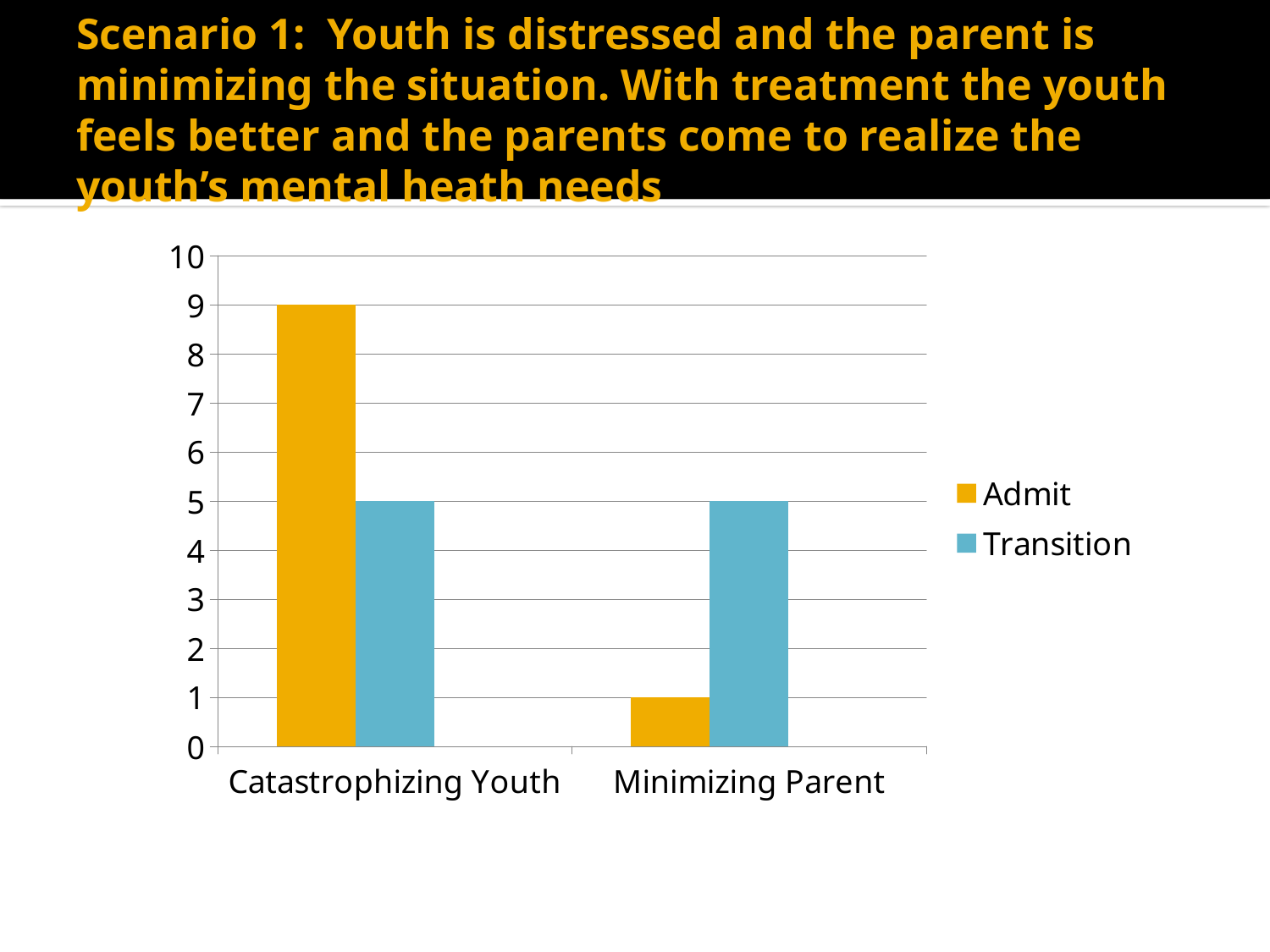
Which category has the lowest Admit value? Minimizing Parent What is the Admit value for Minimizing Parent? 1 Which series is shown in blue in the legend? Transition How many categories are shown on the x axis? 2 Which category has the highest Admit value? Catastrophizing Youth What is the Admit value for Catastrophizing Youth? 9 How many series does the legend list? 2 What kind of chart is shown on the slide? bar chart What is the difference between the Admit and Transition values for Catastrophizing Youth? 4 What is the Transition value for Catastrophizing Youth? 5 What is the Transition value for Minimizing Parent? 5 For Minimizing Parent, which is larger, the Admit value or the Transition value? Transition